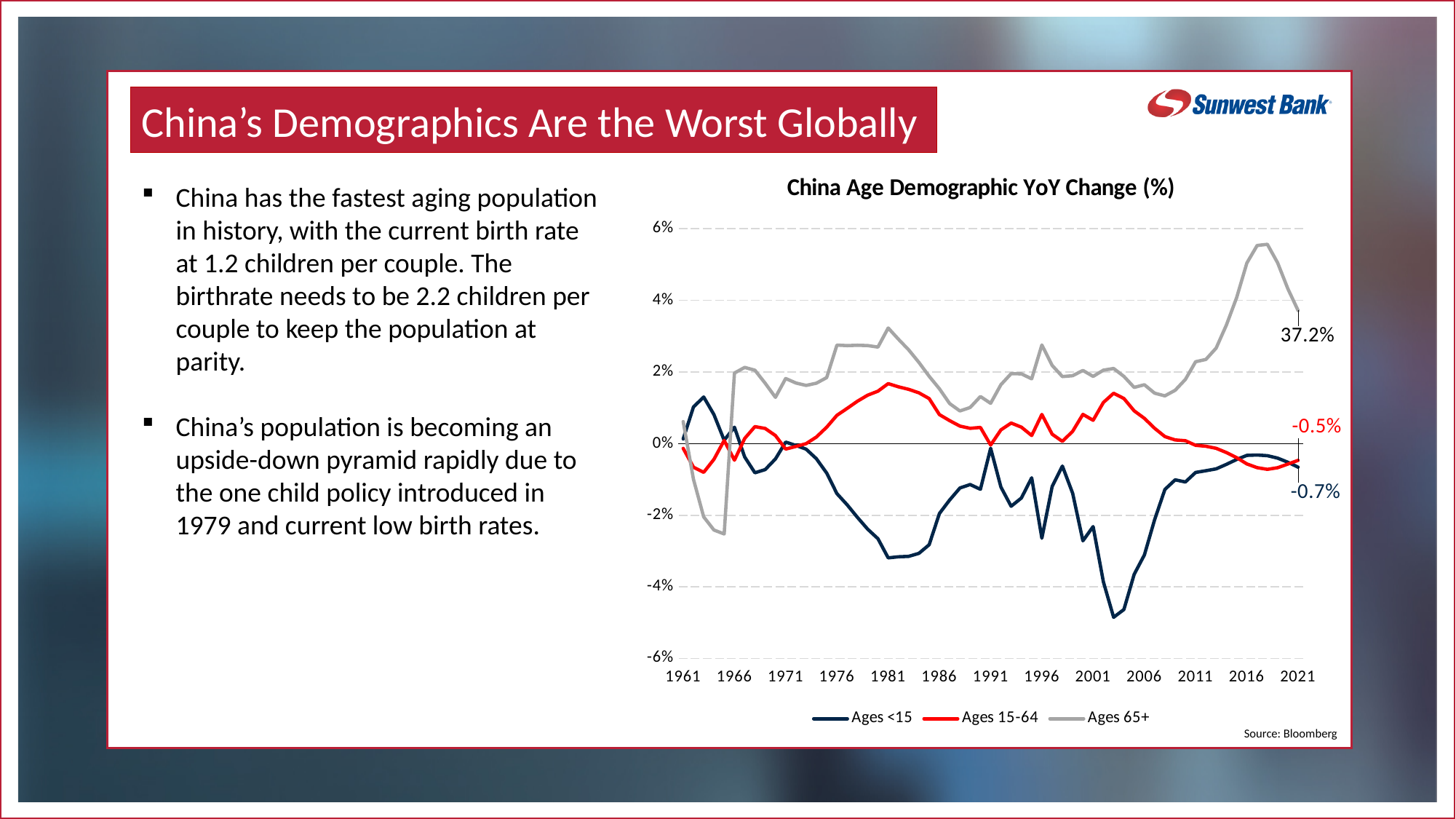
What value is labelled at the end of the Ages <15 line? -0.7% Is the lowest value of the Ages <15 line, around 2003, greater or less than -4%? less Does the Ages 65+ line rise or fall between 2011 and 2017? rise What is the title of the chart? China Age Demographic YoY Change (%) Which series has the highest value at the right end of the chart (2021)? Ages 65+ What value is labelled at the end of the Ages 65+ line? 37.2% How many series does the chart legend list? 3 What value is labelled at the end of the Ages 15-64 line? -0.5% Is the peak value of the Ages 65+ line around 2017-2018 greater or less than 4%? greater At the end of the chart, which is larger: the labelled value for Ages 15-64 or for Ages <15? Ages 15-64 How many year labels are shown on the x axis? 13 What kind of chart is shown on the slide? line chart